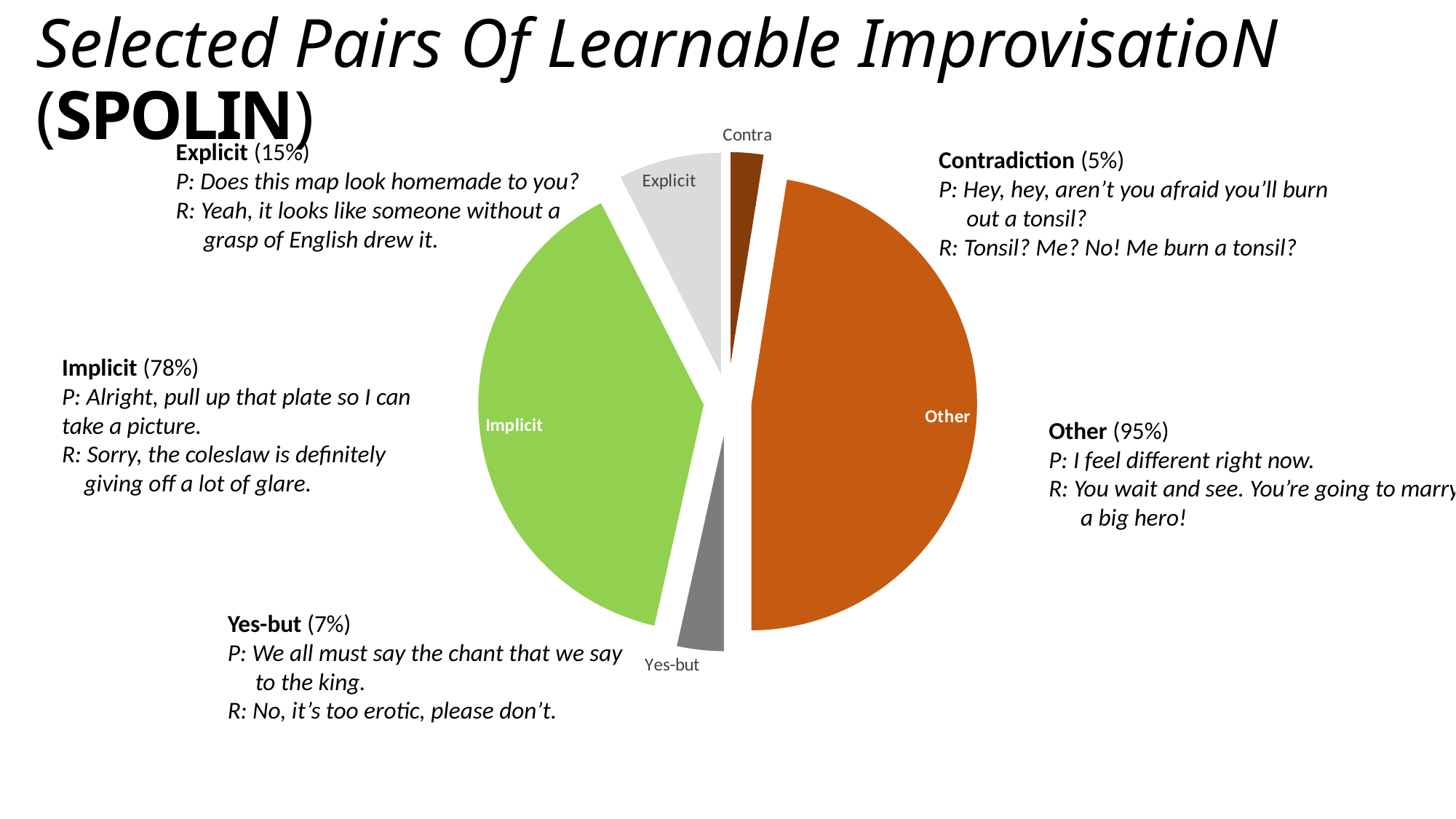
Which slice is larger in the pie chart, Implicit or Explicit? Implicit Which slice is larger in the pie chart, Implicit or Yes-but? Implicit How many slices does the pie chart have? 5 What colour is the Other slice in the pie chart? orange Which slice is larger in the pie chart, Other or Implicit? Other Which slice of the pie chart is the smallest? Contra Which slice of the pie chart is the largest? Other What kind of chart is shown on the slide? pie chart What colour is the Implicit slice in the pie chart? green